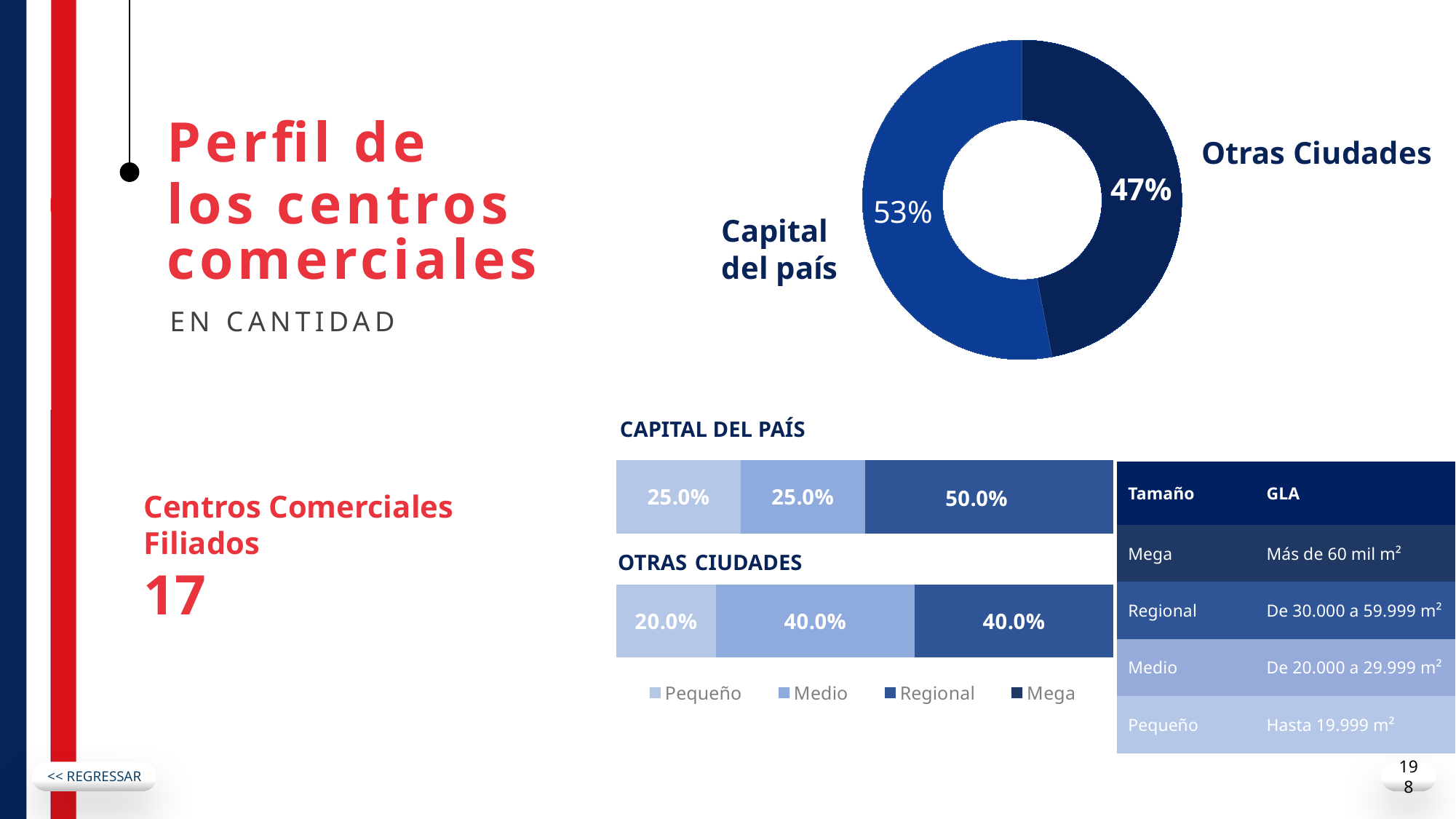
In the CAPITAL DEL PAÍS stacked bar, what is the value for Regional? 50.0% In the OTRAS CIUDADES stacked bar, what is the value for Pequeño? 20.0% In the donut chart, what share is shown for Capital del país? 53% In the donut chart, which segment is larger, Capital del país or Otras Ciudades? Capital del país In the CAPITAL DEL PAÍS stacked bar, which segment is the largest? Regional In the OTRAS CIUDADES stacked bar, what is the value for Medio? 40.0% How many series does the legend below the stacked bars list? 4 In the donut chart, what is the difference between the Capital del país share and the Otras Ciudades share? 6% In the donut chart, what share is shown for Otras Ciudades? 47% In the CAPITAL DEL PAÍS stacked bar, what is the value for Pequeño? 25.0% What is the difference between the Pequeño value in CAPITAL DEL PAÍS and the Pequeño value in OTRAS CIUDADES? 5.0% What kind of chart is the chart at the top right of the slide? Donut (pie) chart